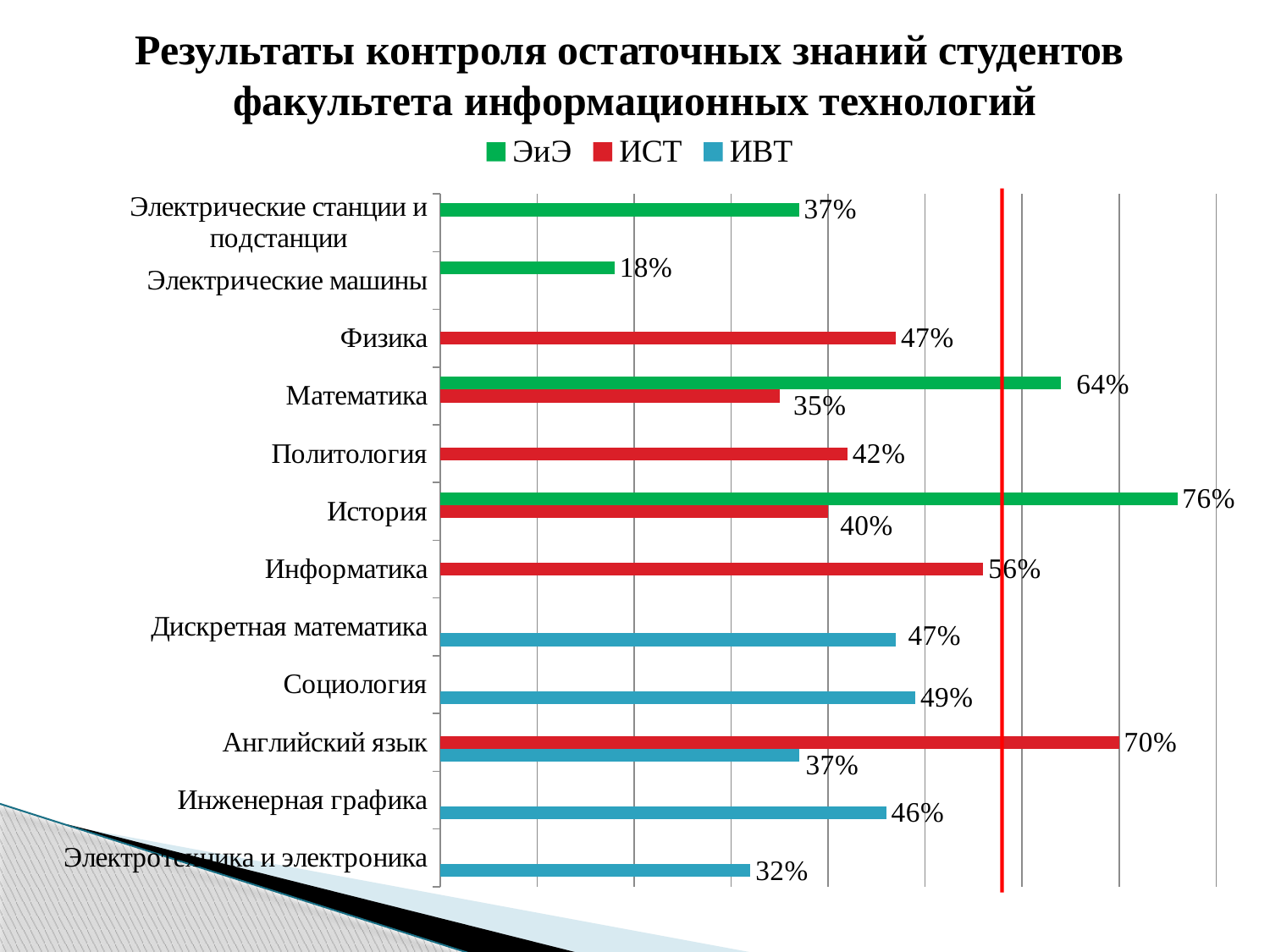
In Английский язык, which series has the larger value, ИСТ or ИВТ? ИСТ What is the value for ЭиЭ in Электрические машины? 18% What is the value for ИВТ in Электротехника и электроника? 32% Which colour represents the ИВТ series in the legend? blue How many categories (subjects) are shown on the chart? 12 How many series does the legend list? 3 What is the value for ИСТ in Английский язык? 70% Which subject has the highest value for the ЭиЭ series? История Which subject has the lowest value for the ИВТ series? Электротехника и электроника What is the difference between the ЭиЭ and ИСТ values in Математика? 29% What is the value for ЭиЭ in История? 76% What kind of chart is shown on the slide? bar chart